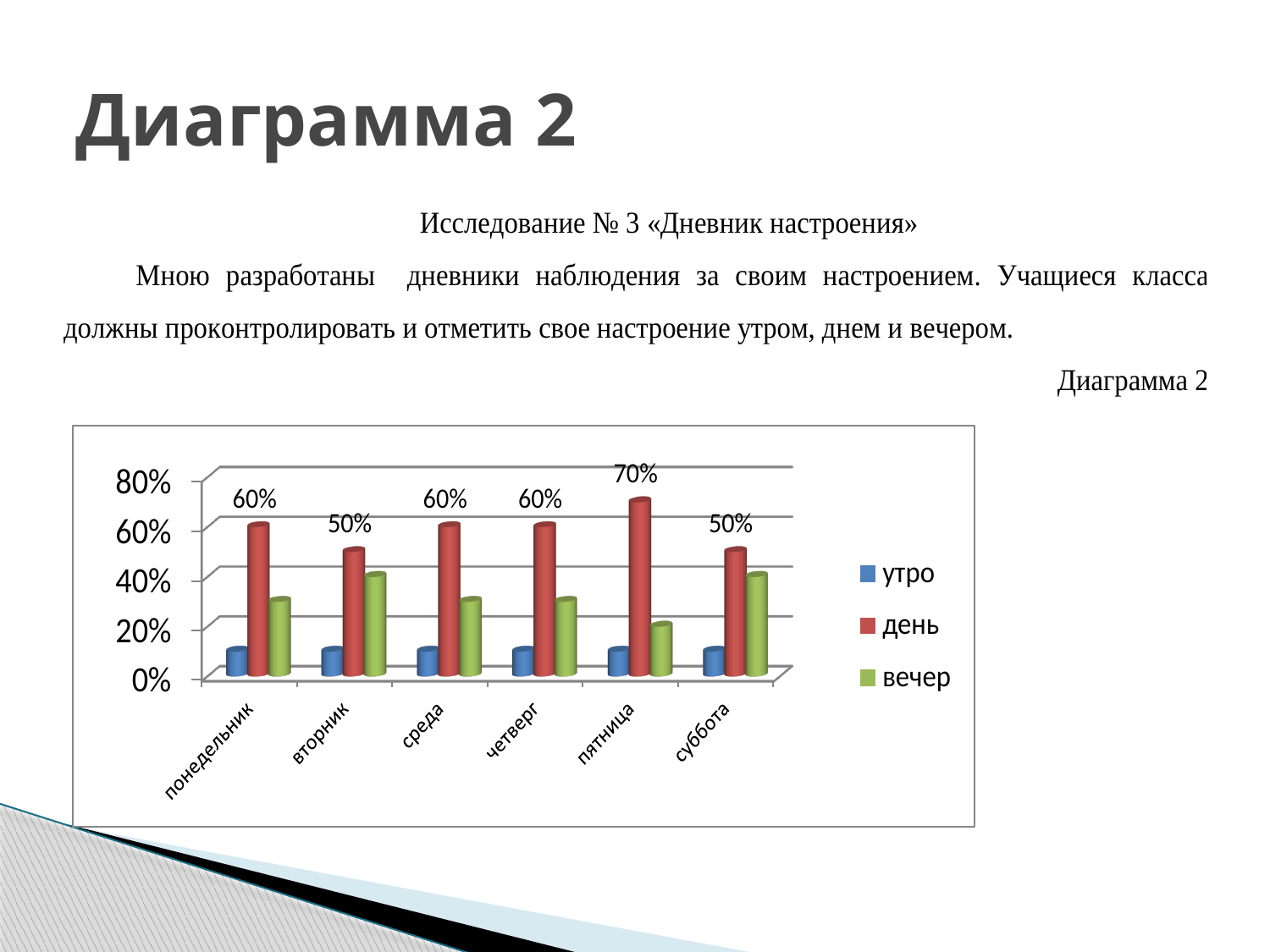
Is the value for вечер on вторник greater or less than 20%? greater What is the difference between the день values for пятница and суббота? 20% What are the three series listed in the legend? утро, день, вечер Which is larger, the день value for понедельник or for вторник? понедельник What is the value for день on вторник? 50% Is the value for утро on среда greater or less than 20%? less How many series does the legend list? 3 What kind of chart is shown on the slide? bar chart What is the value for день on пятница? 70% On which day is the день value highest? пятница What is the value for день on среда? 60% How many days are shown on the x axis of the chart? 6